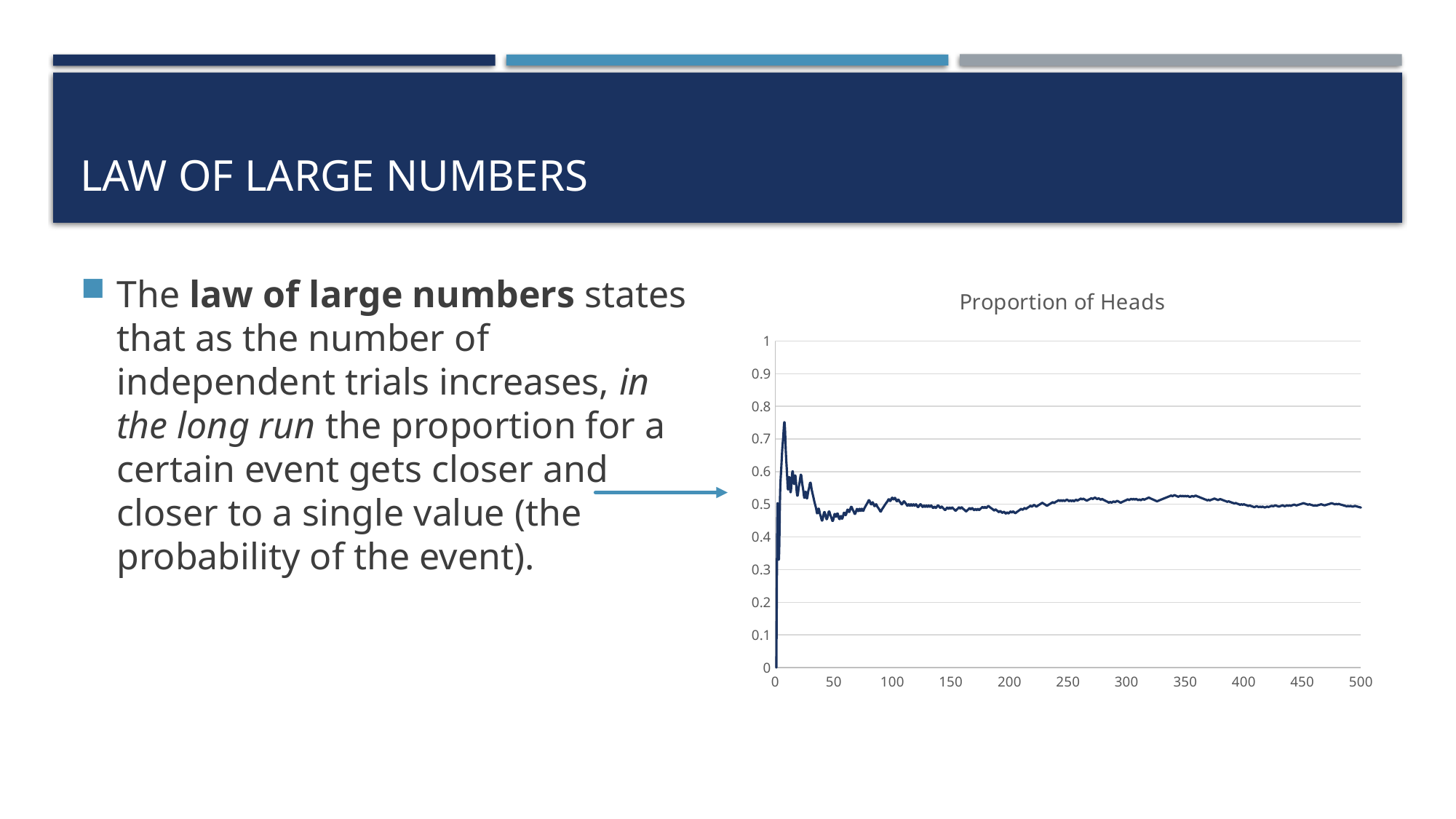
In the Proportion of Heads chart, which round value on the y axis does the line settle close to as the number of trials increases: 0.5 or 0.8? 0.5 What is the title of the chart on the slide? Proportion of Heads In the Proportion of Heads chart, is the value at 300 trials greater or less than 0.3? greater What is the largest value labelled on the x axis of the Proportion of Heads chart? 500 In the Proportion of Heads chart, is the value at 300 trials greater or less than 0.7? less In the Proportion of Heads chart, does the line fluctuate more at the start (near 0 trials) or at the end (near 500 trials)? at the start What kind of chart is shown on the slide? line chart How many lines are plotted in the Proportion of Heads chart? 1 In the Proportion of Heads chart, is the highest point of the line greater or less than 0.6? greater What is the highest value labelled on the y axis of the Proportion of Heads chart? 1